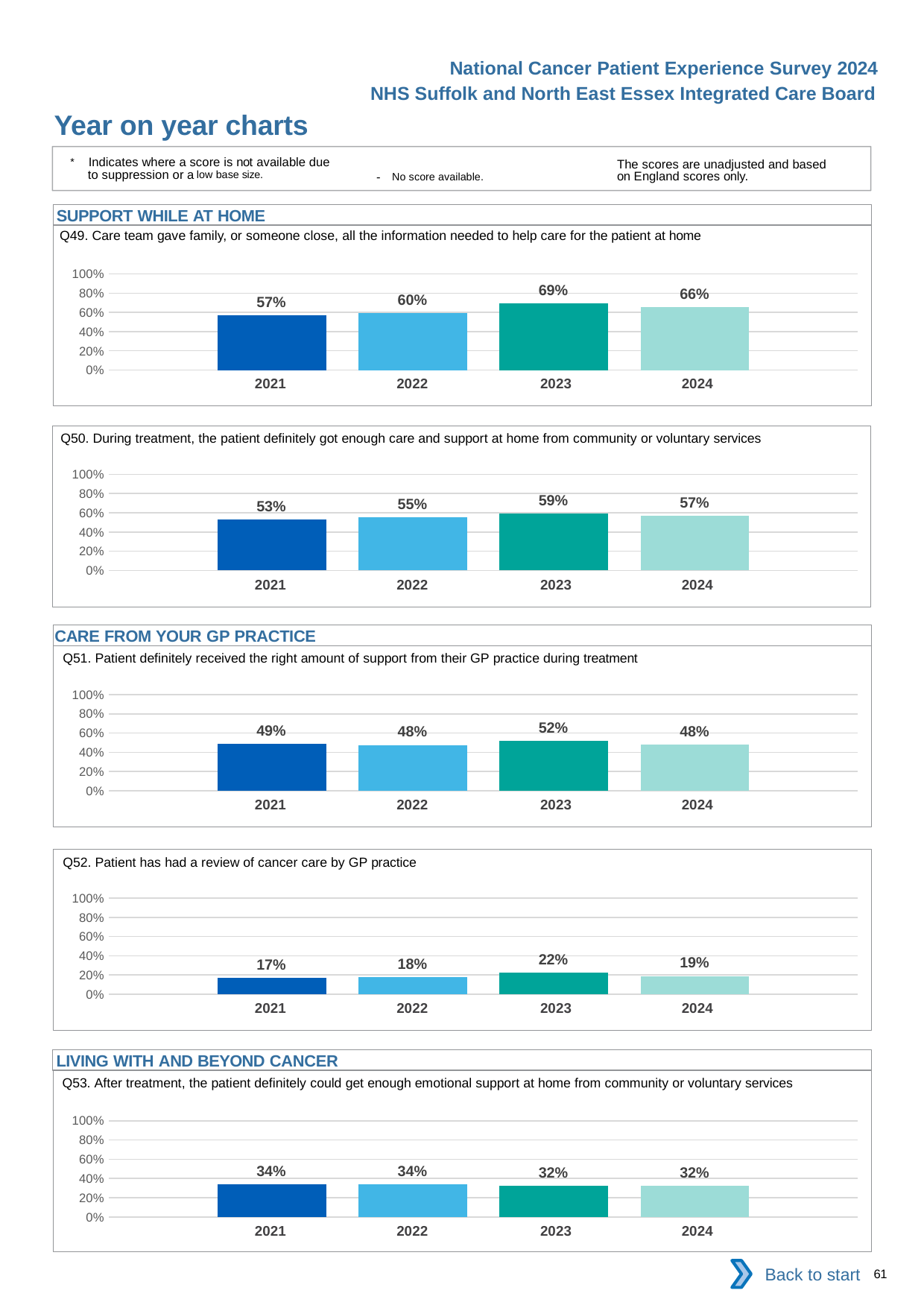
In the Q53 chart, how many years are plotted? 4 In the Q50 chart, which year has the highest value? 2023 In the Q52 chart, what is the value for 2021? 17% What kind of chart is the Q49 chart? Bar chart In the Q53 chart, what is the difference between the 2021 and 2024 values? 2% In the Q51 chart, which is larger, the value for 2021 or the value for 2023? 2023 In the Q52 chart, is the value for 2023 greater or less than 40%? less In the Q49 chart, do the values rise or fall from 2021 to 2023? Rise In the Q50 chart, what is the difference between the 2023 and 2021 values? 6% In the Q51 chart, what is the value for 2024? 48% In the Q49 chart, what is the value for 2023? 69% In the Q49 chart, which year has the lowest value? 2021